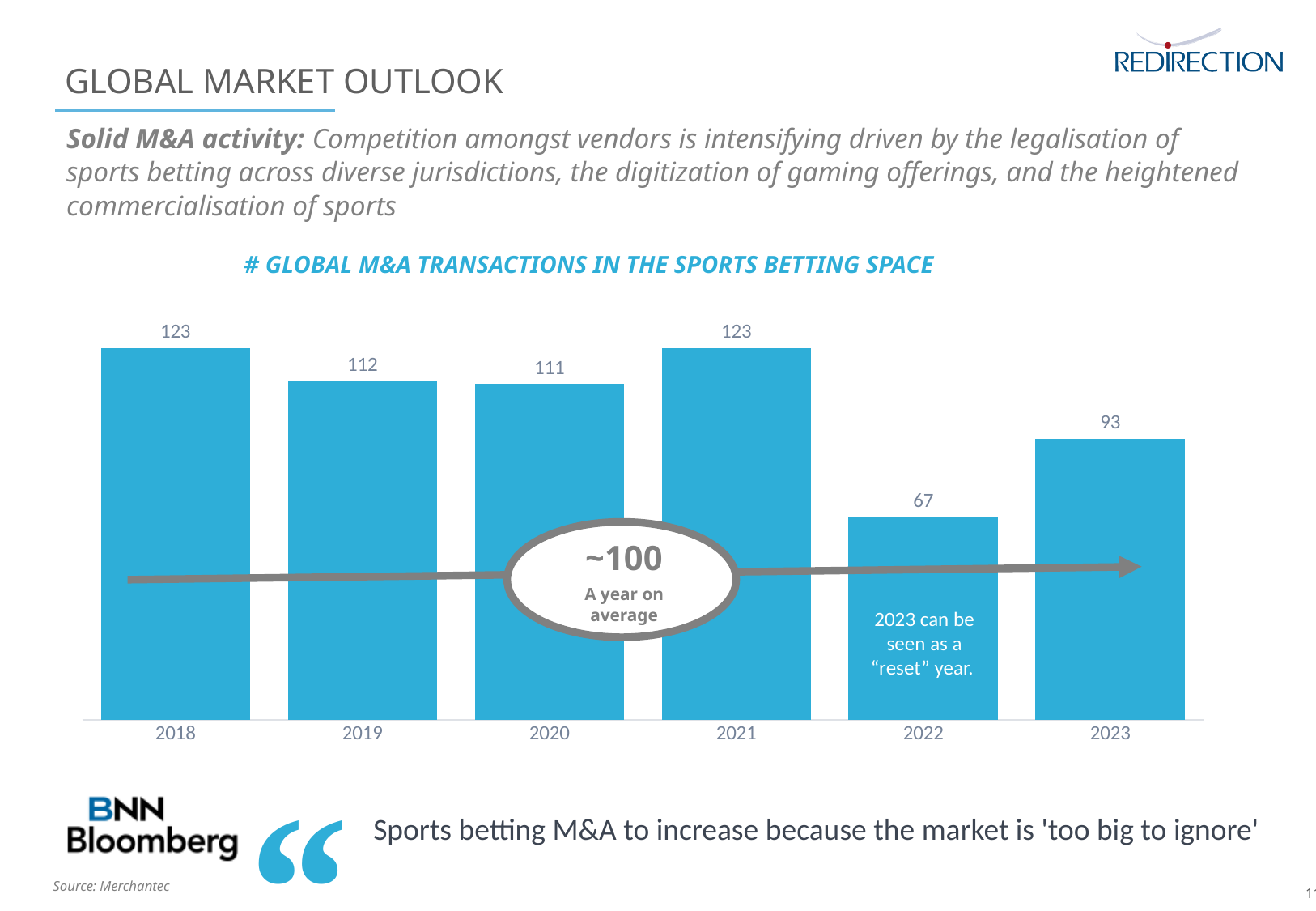
How many years are shown in the chart of global M&A transactions in the sports betting space? 6 What kind of chart is used to show global M&A transactions in the sports betting space? Bar chart What is the number of global M&A transactions in the sports betting space in 2019? 112 What is the title of the chart on the slide? # GLOBAL M&A TRANSACTIONS IN THE SPORTS BETTING SPACE Which year had more global M&A transactions in the sports betting space, 2020 or 2023? 2020 What is the difference in the number of global M&A transactions between 2019 and 2020? 1 Did the number of global M&A transactions rise or fall from 2021 to 2022? Fall What is the number of global M&A transactions in the sports betting space in 2022? 67 What is the number of global M&A transactions in the sports betting space in 2023? 93 Which year has the lowest number of global M&A transactions in the sports betting space? 2022 According to the annotation on the chart, roughly how many global M&A transactions occur per year on average? ~100 What is the difference in the number of global M&A transactions between 2021 and 2022? 56